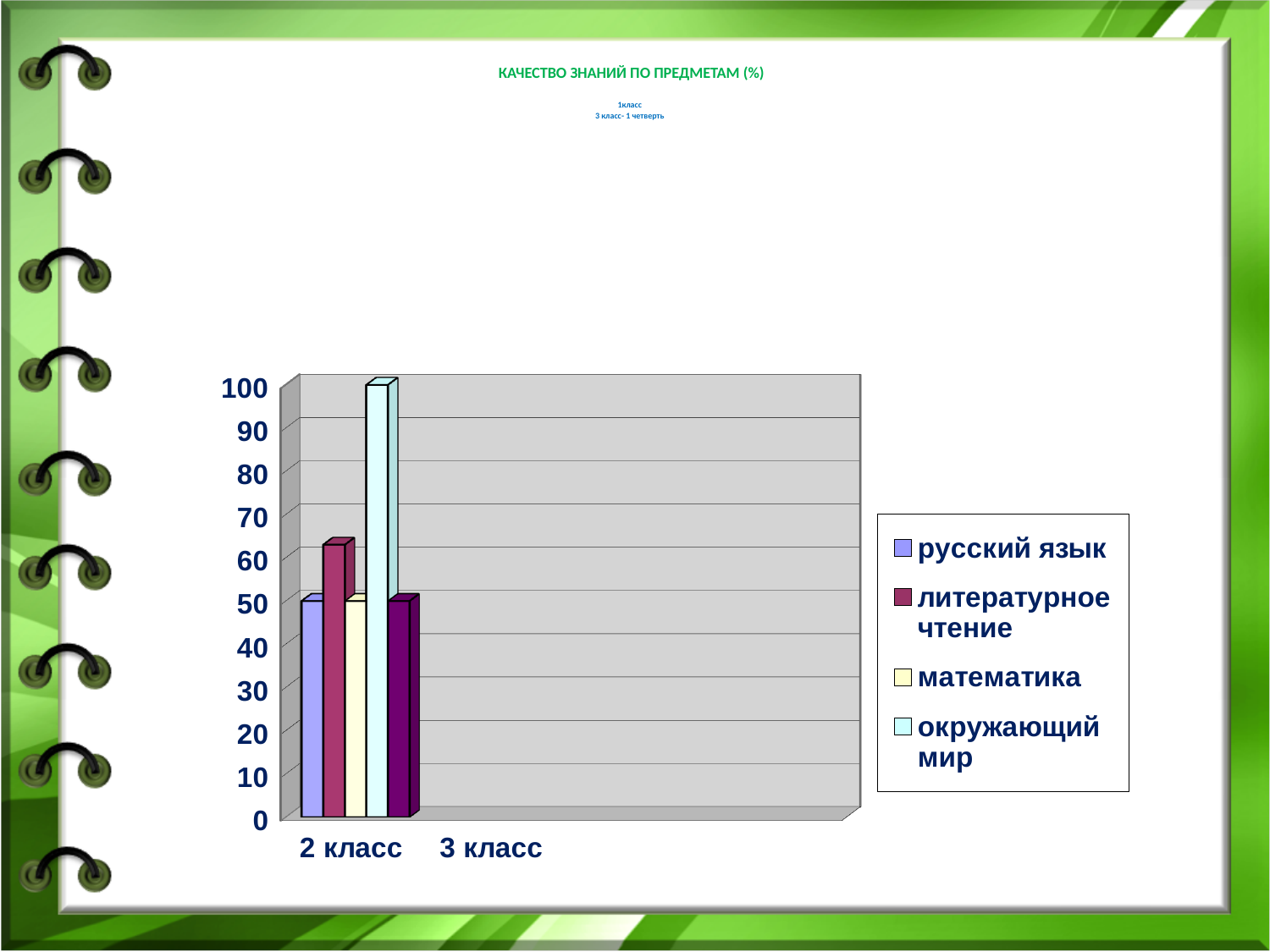
How many categories are labelled on the x axis? 2 For 2 класс, which is larger: окружающий мир or математика? окружающий мир How many series does the legend list? 4 Is the value for окружающий мир in 2 класс greater or less than 90? greater Is the value for математика in 2 класс greater or less than 70? less What is the highest value shown on the vertical axis? 100 For 2 класс, which is larger: литературное чтение or русский язык? литературное чтение Is the value for литературное чтение in 2 класс greater or less than 70? less What is the title of the chart? КАЧЕСТВО ЗНАНИЙ ПО ПРЕДМЕТАМ (%) Which subject has the highest value for 2 класс? окружающий мир What kind of chart is shown on the slide? bar chart